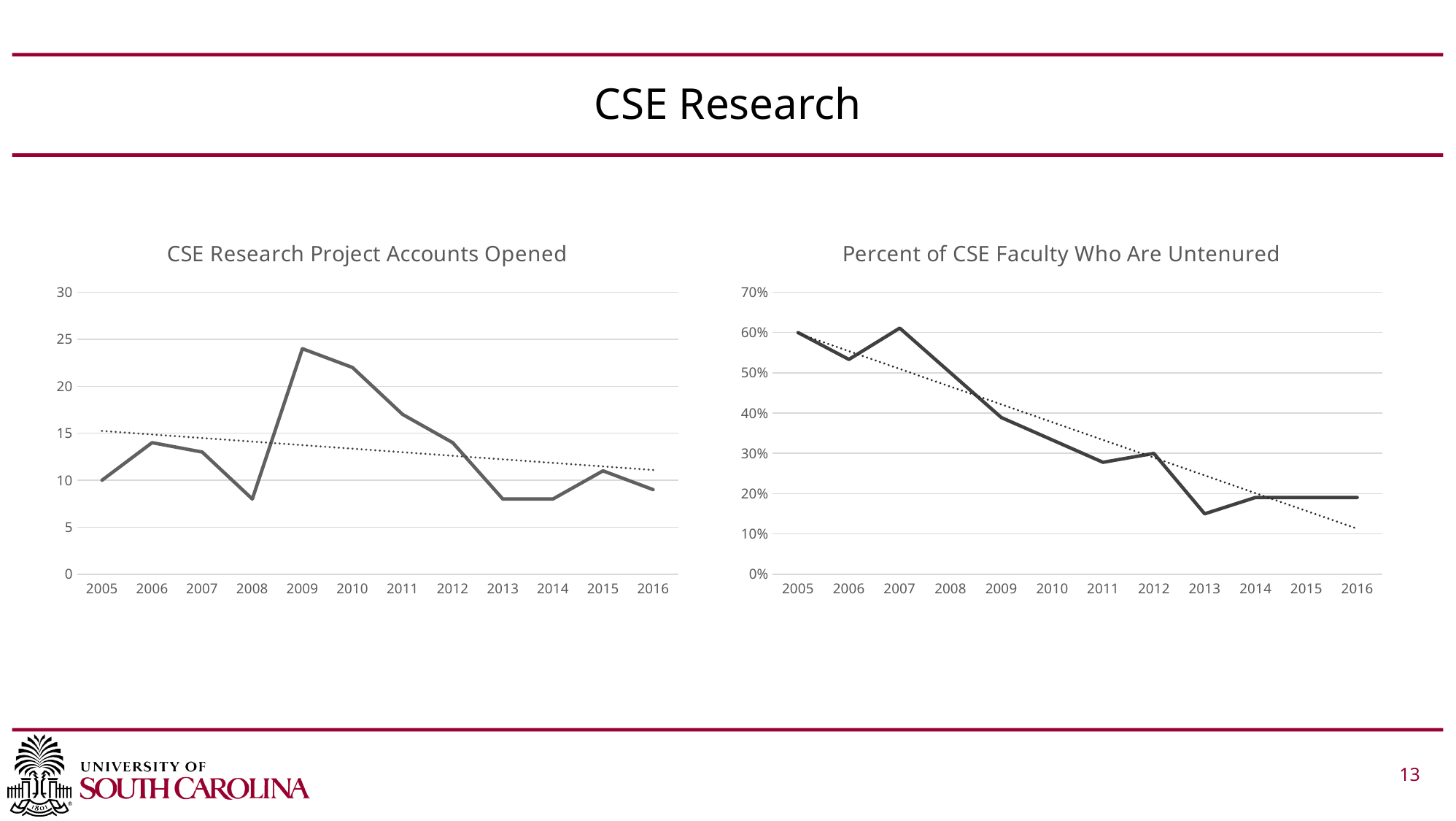
In the 'Percent of CSE Faculty Who Are Untenured' chart, what is the value for 2005? 60% What is the title of the chart on the right side of the slide? Percent of CSE Faculty Who Are Untenured In the 'CSE Research Project Accounts Opened' chart, which year has the highest value? 2009 In the 'Percent of CSE Faculty Who Are Untenured' chart, is the value for 2011 greater or less than 30%? less What kind of chart is the 'CSE Research Project Accounts Opened' chart? line chart In the 'CSE Research Project Accounts Opened' chart, is the value for 2009 greater or less than 20? greater In the 'CSE Research Project Accounts Opened' chart, what is the value for 2005? 10 In the 'CSE Research Project Accounts Opened' chart, is the value for 2008 greater or less than 10? less In the 'Percent of CSE Faculty Who Are Untenured' chart, do the values generally rise or fall from 2005 to 2016? fall In the 'CSE Research Project Accounts Opened' chart, which is larger, the value for 2010 or the value for 2012? 2010 How many years are plotted on the x axis of the 'CSE Research Project Accounts Opened' chart? 12 In the 'Percent of CSE Faculty Who Are Untenured' chart, which year has the lowest value? 2013